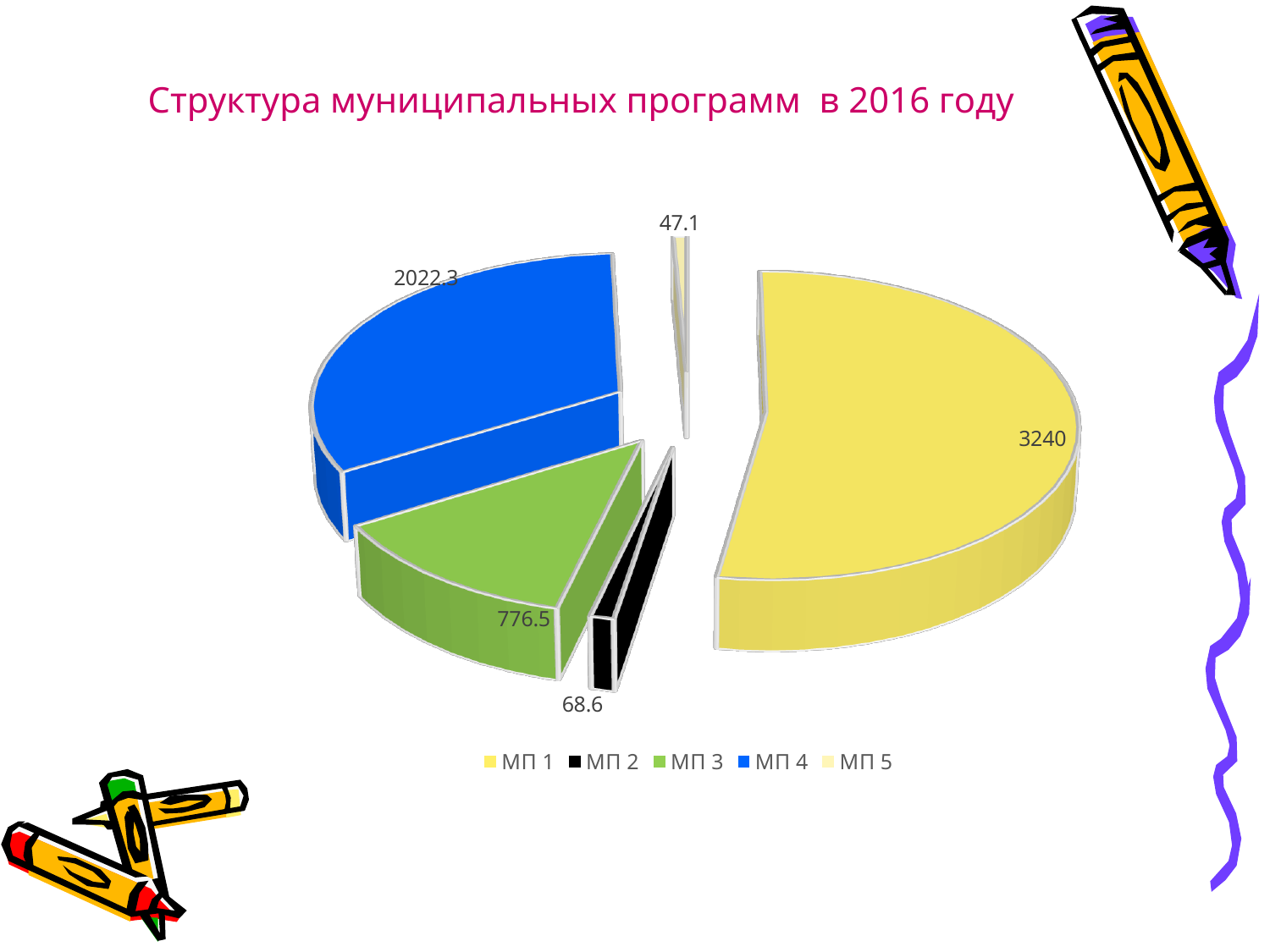
What is the value for МП 1? 3240 What is the value for МП 2? 68.6 Which category has the smallest slice? МП 5 What is the value for МП 5? 47.1 How many categories does the pie chart have? 5 What is the value for МП 4? 2022.3 What is the difference between the values for МП 1 and МП 4? 1217.7 What kind of chart is shown on the slide? Pie chart Which category has the largest slice? МП 1 What is the value for МП 3? 776.5 What is the title of the chart? Структура муниципальных программ в 2016 году Which is larger, the value for МП 3 or the value for МП 2? МП 3